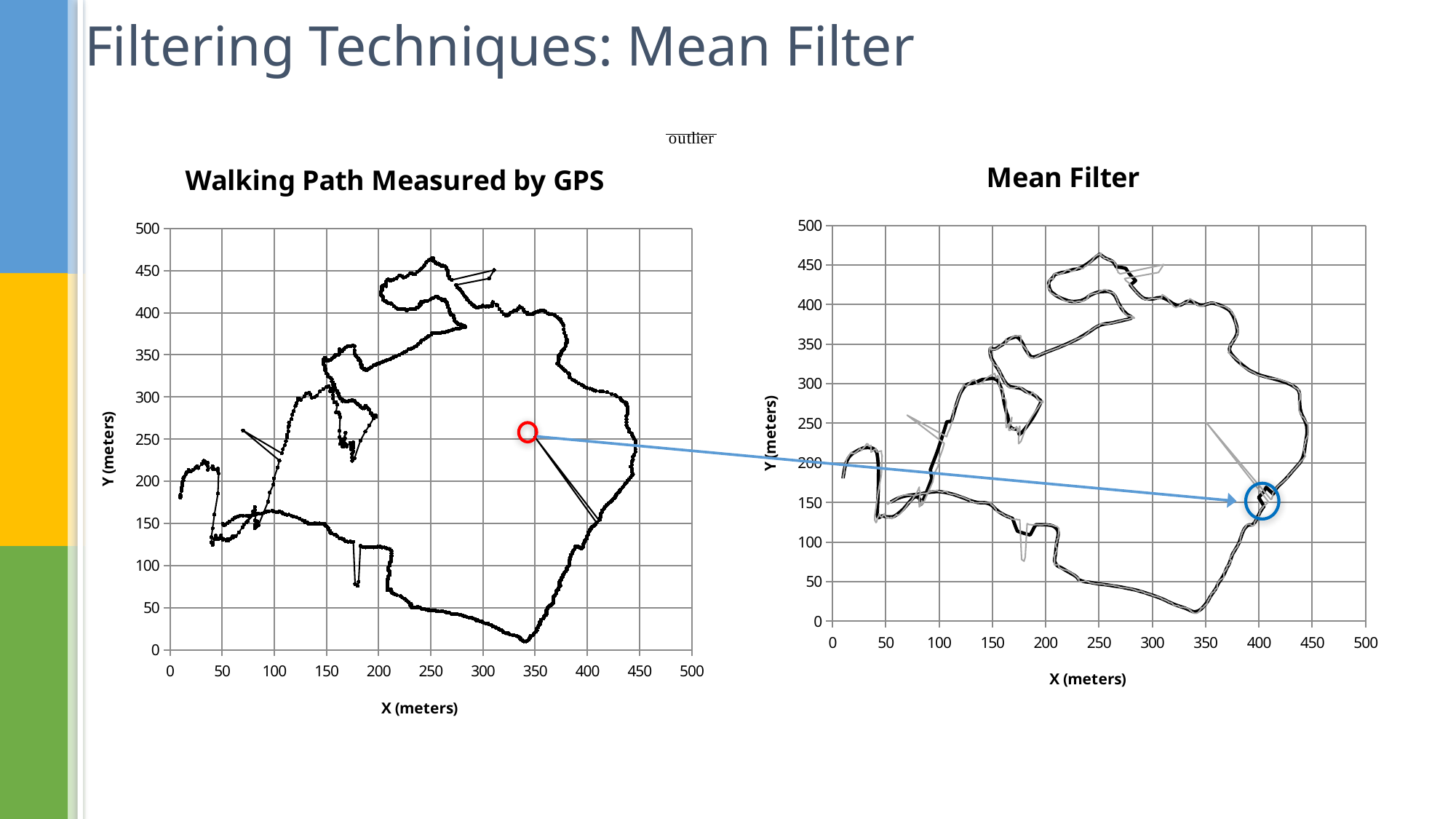
In the right chart "Mean Filter", is the lowest Y value reached by the path greater or less than 50? less What is the title of the right chart? Mean Filter In the left chart "Walking Path Measured by GPS", is the largest X value reached by the path greater or less than 400? greater What kind of chart is the left chart titled "Walking Path Measured by GPS"? scatter chart In the right chart "Mean Filter", is the largest X value reached by the path greater or less than 400? greater What kind of chart is the right chart titled "Mean Filter"? scatter chart What is the title of the left chart? Walking Path Measured by GPS